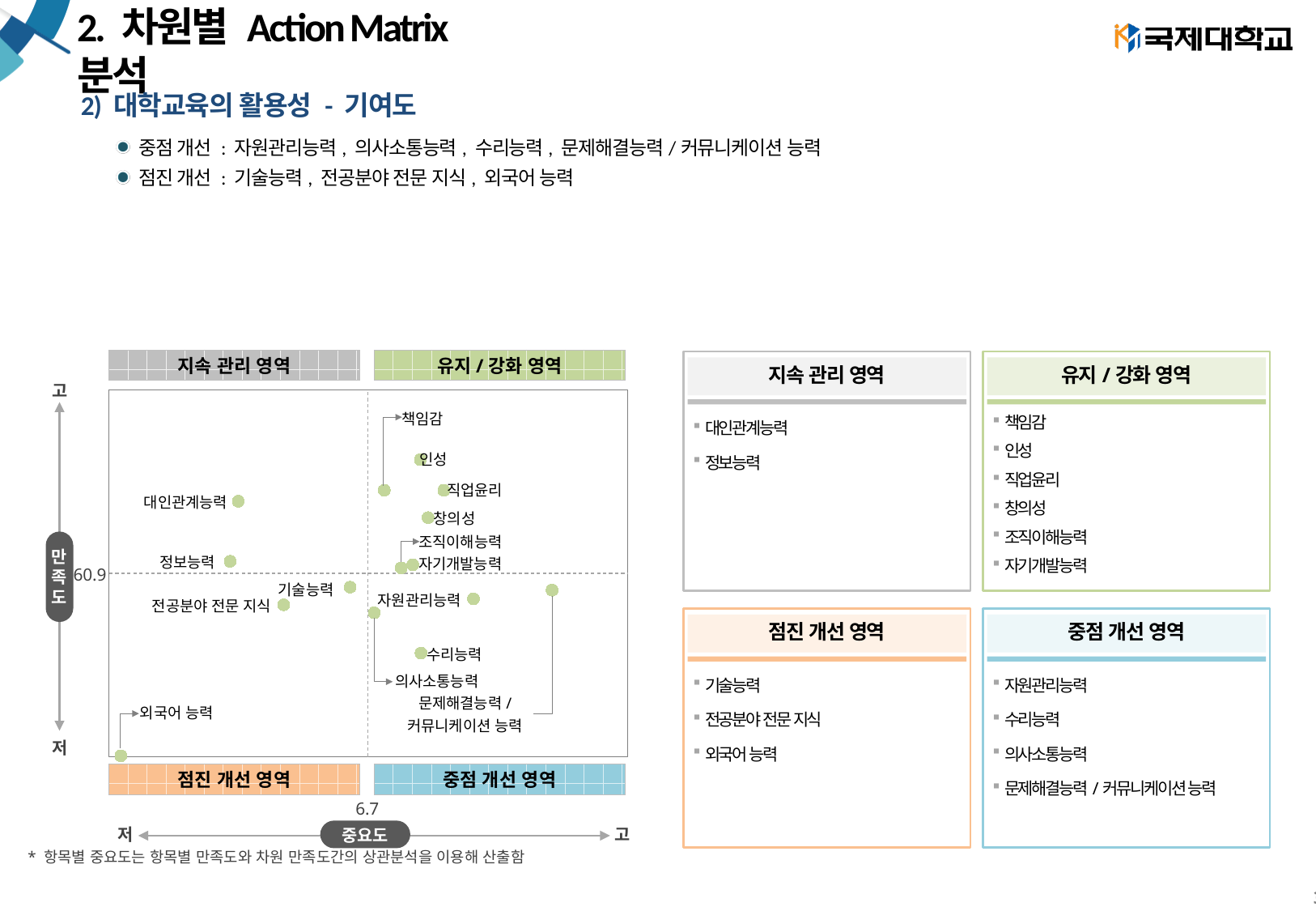
Which item has the highest importance (중요도) in the chart? 문제해결능력 / 커뮤니케이션 능력 What is the label of the vertical axis of the chart? 만족도 Which item has the lowest satisfaction (만족도) in the chart? 외국어 능력 Which item has the lowest importance (중요도) in the chart? 외국어 능력 Which item has the highest satisfaction (만족도) in the chart? 인성 What importance (중요도) value does the vertical dashed reference line mark in the chart? 6.7 Is the importance value for 책임감 greater or less than 6.7? greater How many data points are plotted in the action matrix chart? 15 What satisfaction (만족도) value does the horizontal dashed reference line mark in the chart? 60.9 What kind of chart is shown on the left of the slide? scatter chart Which has higher satisfaction (만족도), 대인관계능력 or 정보능력? 대인관계능력 Is the satisfaction value for 외국어 능력 greater or less than 60.9? less